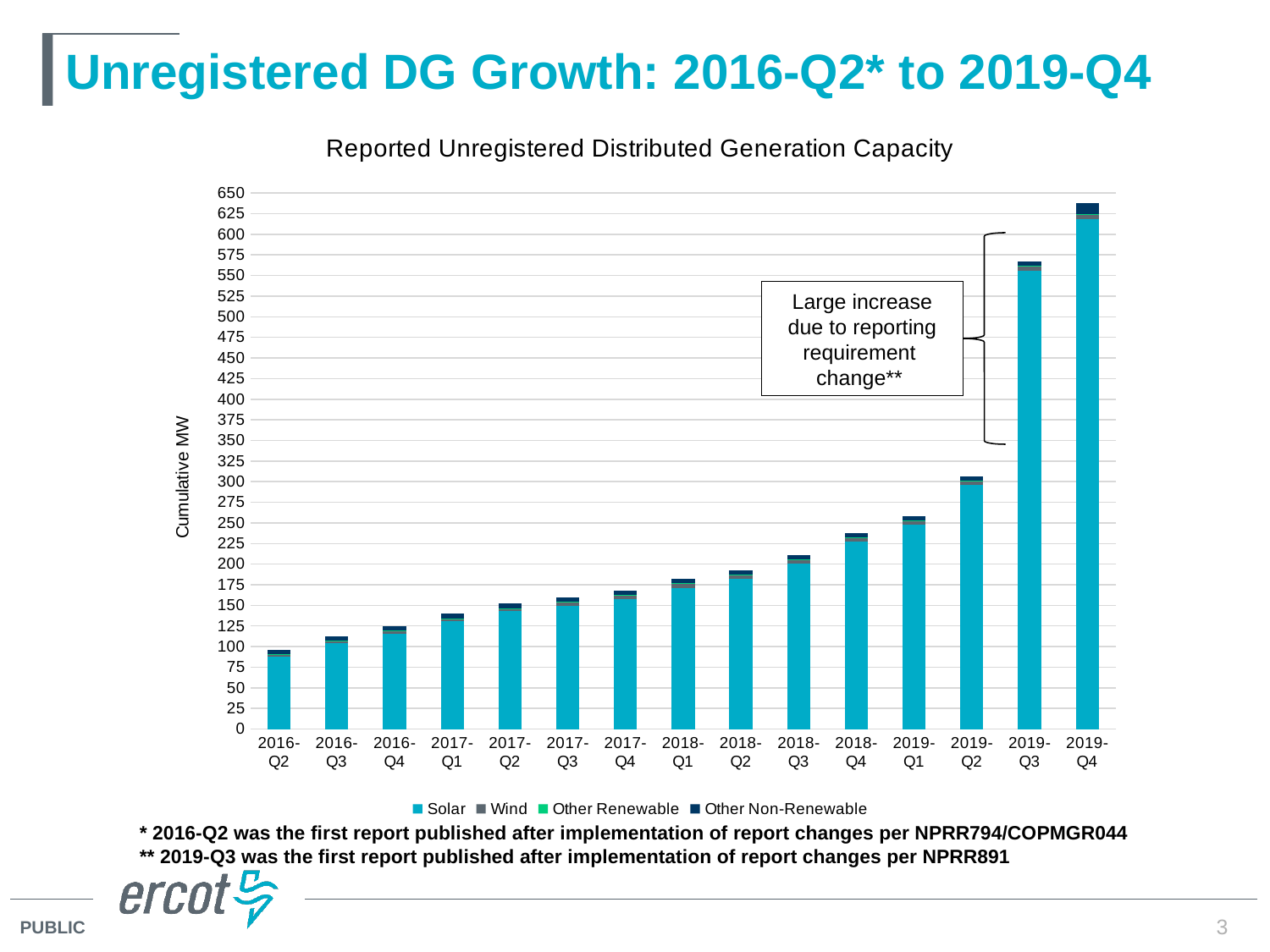
What type of chart is shown on the slide? Stacked bar chart What is the label on the y axis? Cumulative MW Is the total value for 2019-Q4 greater or less than 600? greater Is the total value for 2018-Q4 greater or less than 225? greater Which quarter has the lowest total reported unregistered DG capacity? 2016-Q2 Which is larger, the total for 2019-Q3 or the total for 2019-Q2? 2019-Q3 Do the total values rise or fall from 2016-Q2 to 2019-Q4? Rise Which quarter has the highest total reported unregistered DG capacity? 2019-Q4 What is the title of the chart? Reported Unregistered Distributed Generation Capacity How many series does the legend list? 4 How many quarters (categories) are plotted along the x axis? 15